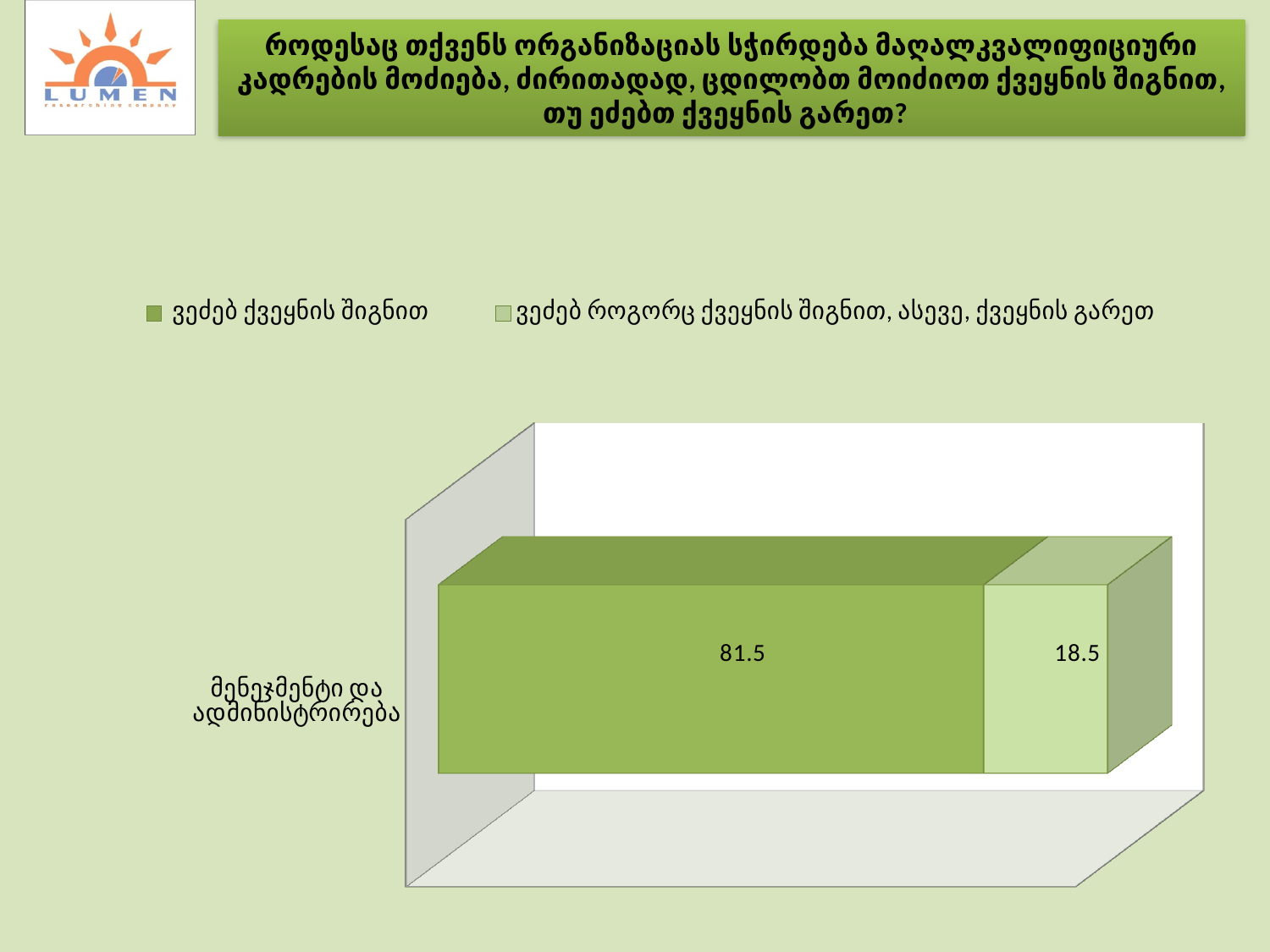
What kind of chart is shown on the slide? Stacked bar chart What is the difference between the values of the two series for "მენეჯმენტი და ადმინისტრირება"? 63 What value is shown for the series "ვეძებ როგორც ქვეყნის შიგნით, ასევე, ქვეყნის გარეთ" for the category "მენეჯმენტი და ადმინისტრირება"? 18.5 Which series is shown in the darker green colour? ვეძებ ქვეყნის შიგნით What value is shown for the series "ვეძებ ქვეყნის შიგნით" for the category "მენეჯმენტი და ადმინისტრირება"? 81.5 How many categories are plotted in the chart? 1 Which series has the larger value for "მენეჯმენტი და ადმინისტრირება"? ვეძებ ქვეყნის შიგნით What is the total of the stacked bar for "მენეჯმენტი და ადმინისტრირება"? 100 Which series has the smallest value in the chart? ვეძებ როგორც ქვეყნის შიგნით, ასევე, ქვეყნის გარეთ How many series does the legend list? 2 What is the label of the category plotted in the chart? მენეჯმენტი და ადმინისტრირება